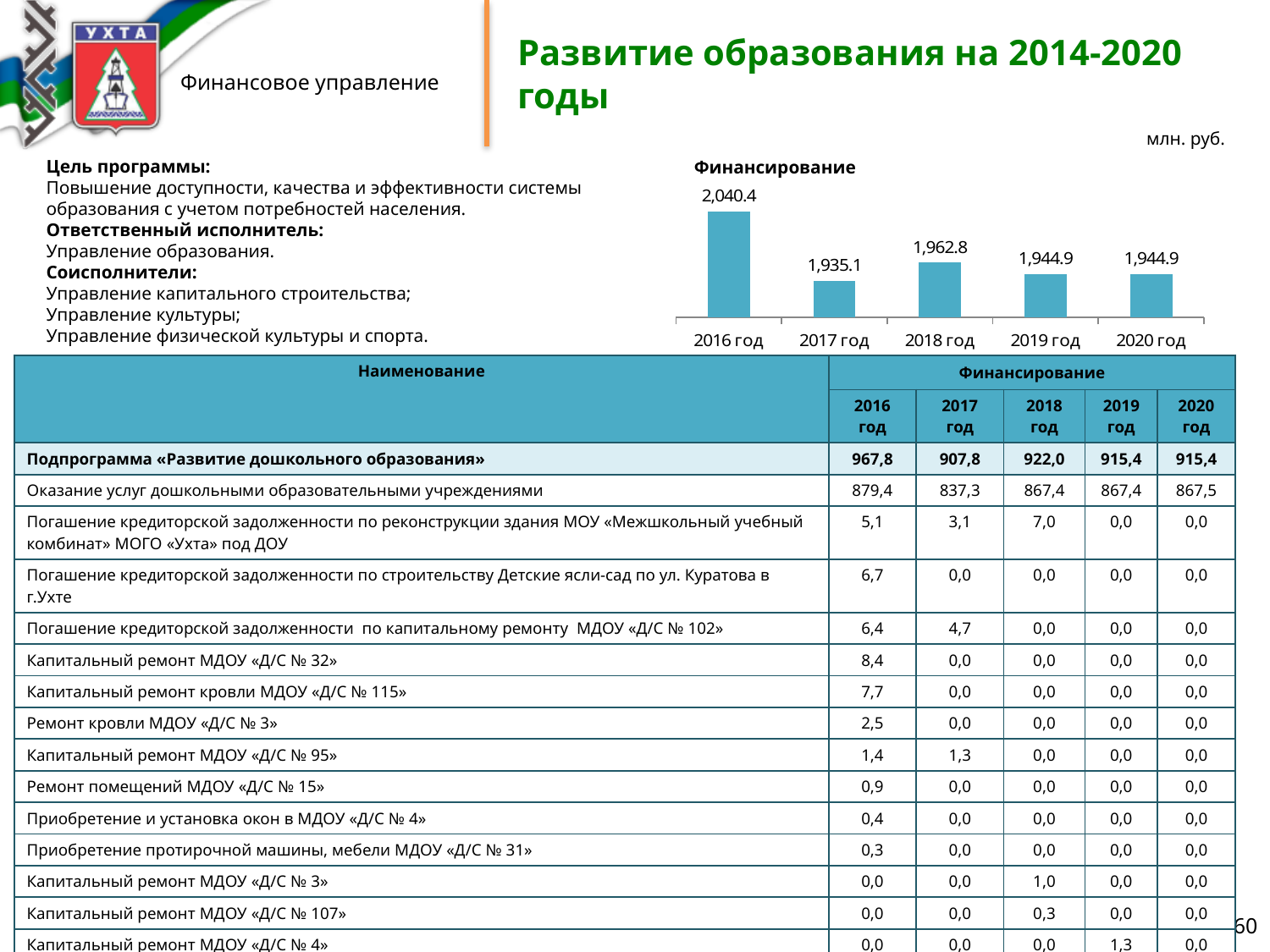
In the Финансирование chart, what is the difference between the values for 2016 год and 2017 год? 105.3 In the Финансирование chart, does the value rise or fall from 2016 год to 2017 год? fall In the Финансирование chart, which is larger: the value for 2017 год or 2018 год? 2018 год Which year has the highest value in the Финансирование chart? 2016 год What is the value for 2018 год in the Финансирование chart? 1,962.8 What kind of chart is the Финансирование chart? bar chart What is the value for 2020 год in the Финансирование chart? 1,944.9 What is the value for 2016 год in the Финансирование chart? 2,040.4 How many years are shown in the Финансирование chart? 5 Which year has the lowest value in the Финансирование chart? 2017 год In the Финансирование chart, what is the difference between the values for 2018 год and 2019 год? 17.9 What unit is indicated for the values in the Финансирование chart? млн. руб.